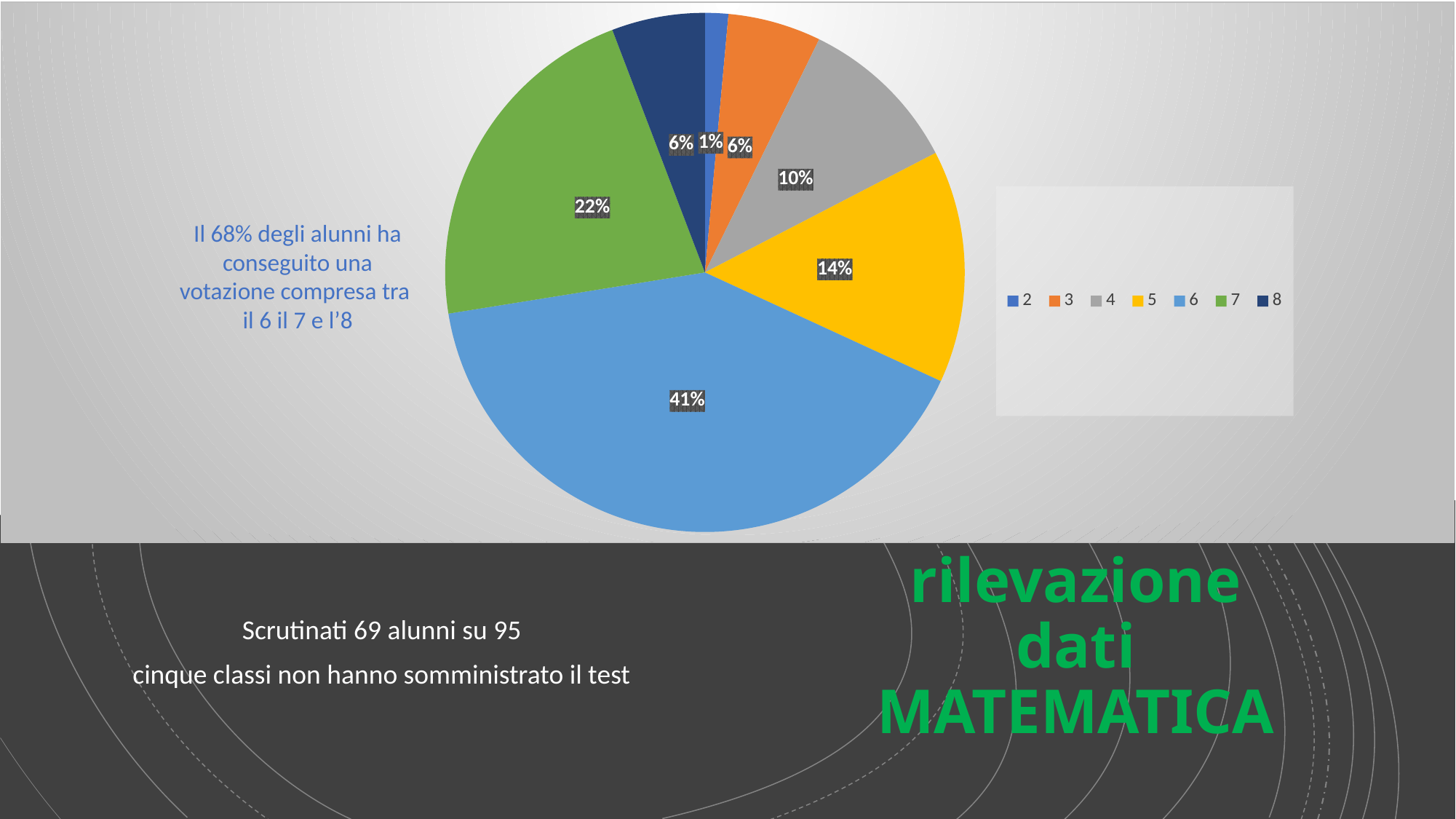
What percentage of students received a grade of 2? 1% How many grade categories does the legend list? 7 What percentage of students received a grade of 6? 41% What kind of chart is shown on the slide? pie chart What percentage of students received a grade of 7? 22% Which slice is larger, grade 5 or grade 4? grade 5 Which grade has the largest slice of the pie? 6 What percentage of students received a grade of 4? 10% What is the difference in percentage points between the slices for grade 6 and grade 7? 19 What colour is the slice for grade 6? light blue What percentage of students received a grade of 5? 14% Which grade has the smallest slice of the pie? 2